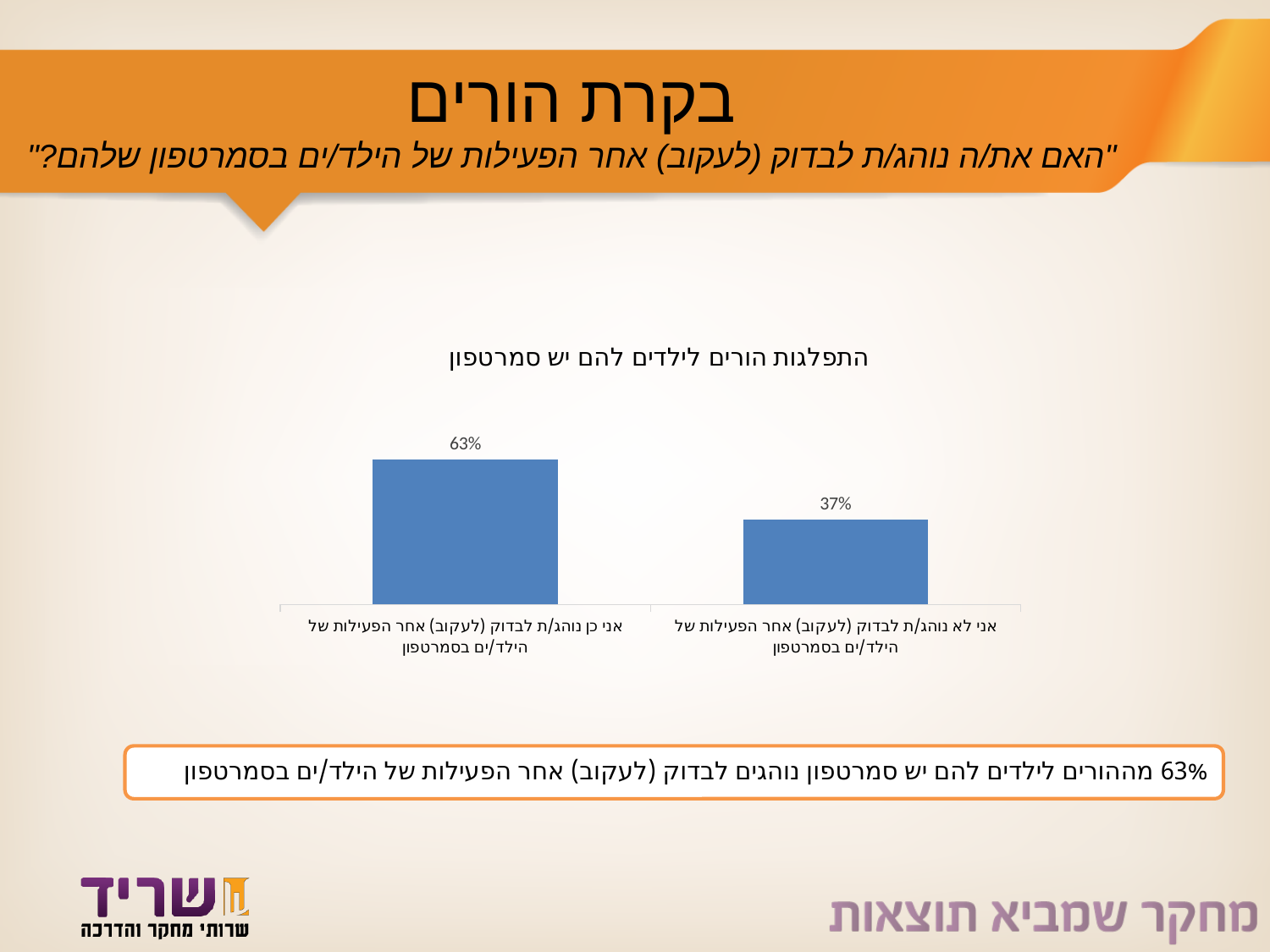
What is the difference between the value for parents who do check their children's smartphone activity and those who do not? 26% What is the value for the category "אני לא נוהג/ת לבדוק (לעקוב) אחר הפעילות של הילד/ים בסמרטפון"? 37% What is the title of the chart? התפלגות הורים לילדים להם יש סמרטפון What colour are the bars in the chart? Blue Which category has the lowest value? אני לא נוהג/ת לבדוק (לעקוב) אחר הפעילות של הילד/ים בסמרטפון How many categories are shown in the chart? 2 Which is larger: the value for parents who do check their children's smartphone activity or the value for those who do not? אני כן נוהג/ת לבדוק (לעקוב) אחר הפעילות של הילד/ים בסמרטפון Which category has the highest value? אני כן נוהג/ת לבדוק (לעקוב) אחר הפעילות של הילד/ים בסמרטפון What is the total of the two values shown in the chart? 100% What is the value for the category "אני כן נוהג/ת לבדוק (לעקוב) אחר הפעילות של הילד/ים בסמרטפון"? 63% What kind of chart is shown on the slide? Bar chart